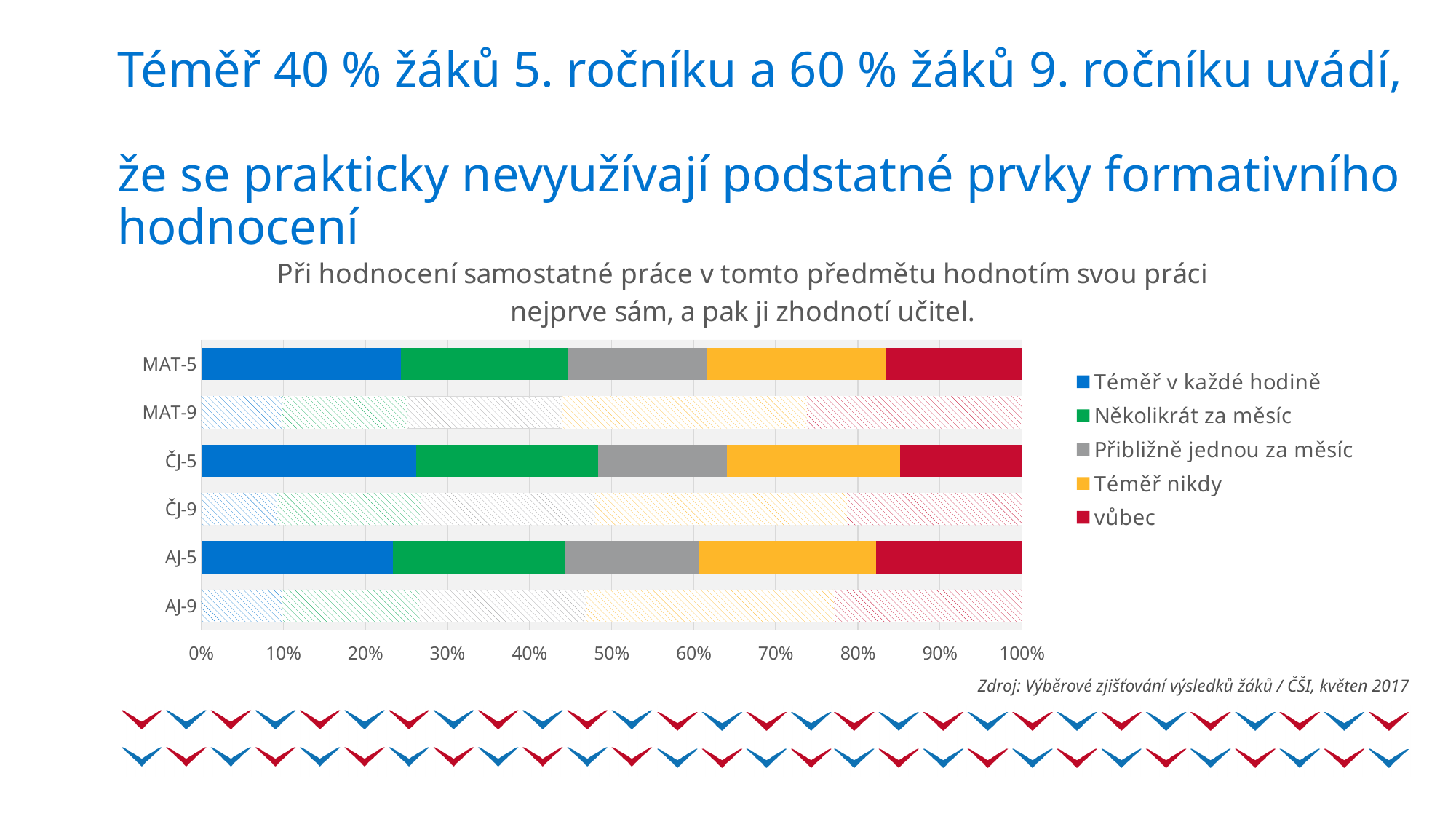
Which category is listed at the top of the chart? MAT-5 What do the segments of each bar add up to? 100% What is the first entry in the chart's legend? Téměř v každé hodině Is the value of "vůbec" for MAT-5 greater or less than 30%? less Is the value of "Téměř v každé hodině" for AJ-5 greater or less than 30%? less How many categories (bars) does the chart show? 6 What is the title of the chart? Při hodnocení samostatné práce v tomto předmětu hodnotím svou práci nejprve sám, a pak ji zhodnotí učitel. What is the highest value shown on the horizontal axis? 100% Is the value of "Téměř v každé hodině" for ČJ-5 greater or less than 30%? less How many series does the legend list? 5 What kind of chart is shown on the slide? stacked bar chart